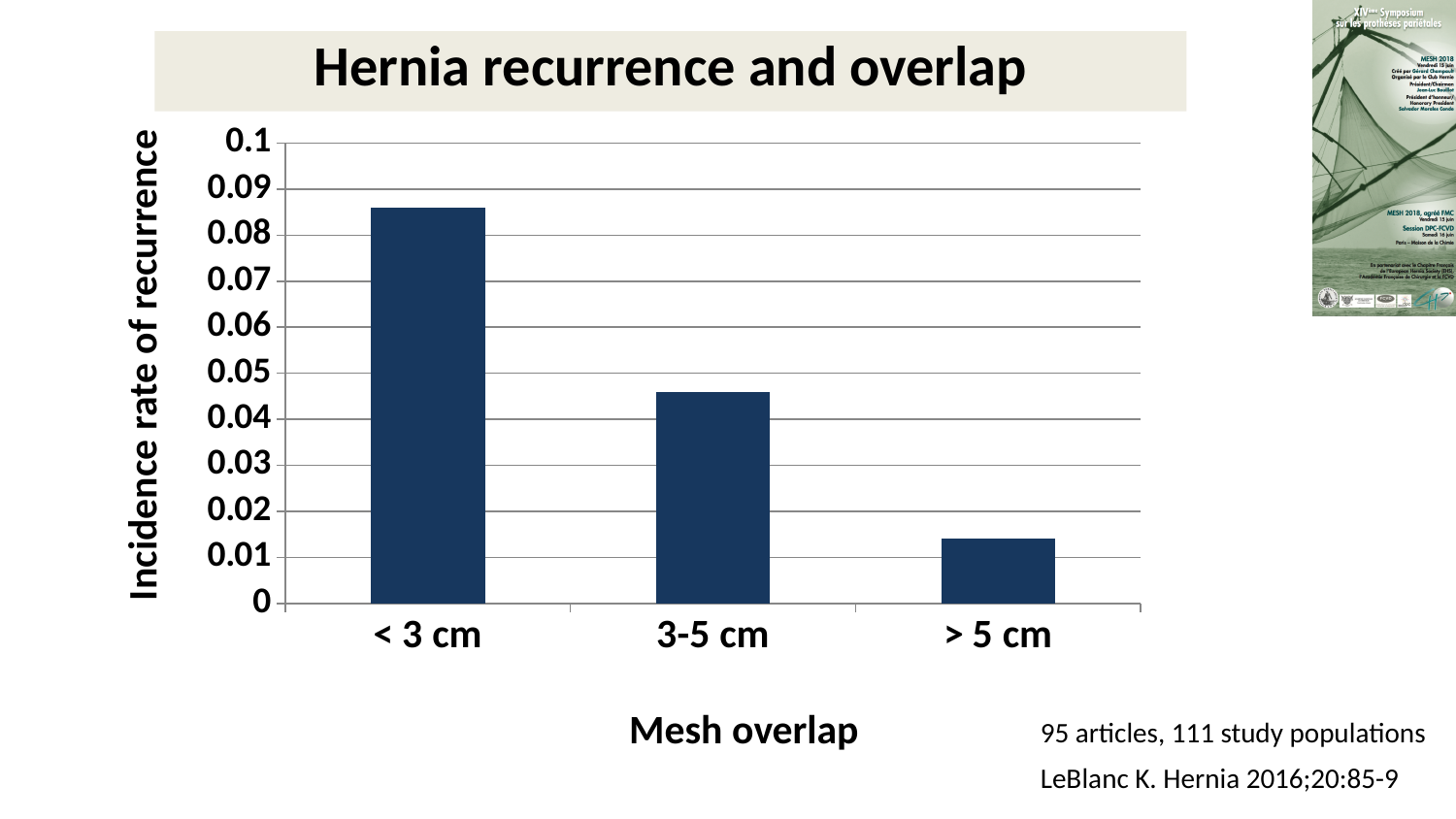
Which mesh overlap category has the lowest incidence rate of recurrence? > 5 cm What kind of chart is shown on the slide? bar chart Is the incidence rate of recurrence for 3-5 cm greater or less than 0.05? less What is the title of the chart? Hernia recurrence and overlap Which mesh overlap category has the highest incidence rate of recurrence? < 3 cm What is the label of the vertical axis? Incidence rate of recurrence How many mesh overlap categories are plotted on the chart? 3 Does the incidence rate of recurrence rise or fall as mesh overlap increases from < 3 cm to > 5 cm? fall Is the incidence rate of recurrence for < 3 cm greater or less than 0.08? greater Which has a higher incidence rate of recurrence, < 3 cm or 3-5 cm? < 3 cm Which has a lower incidence rate of recurrence, 3-5 cm or > 5 cm? > 5 cm Is the incidence rate of recurrence for > 5 cm greater or less than 0.02? less